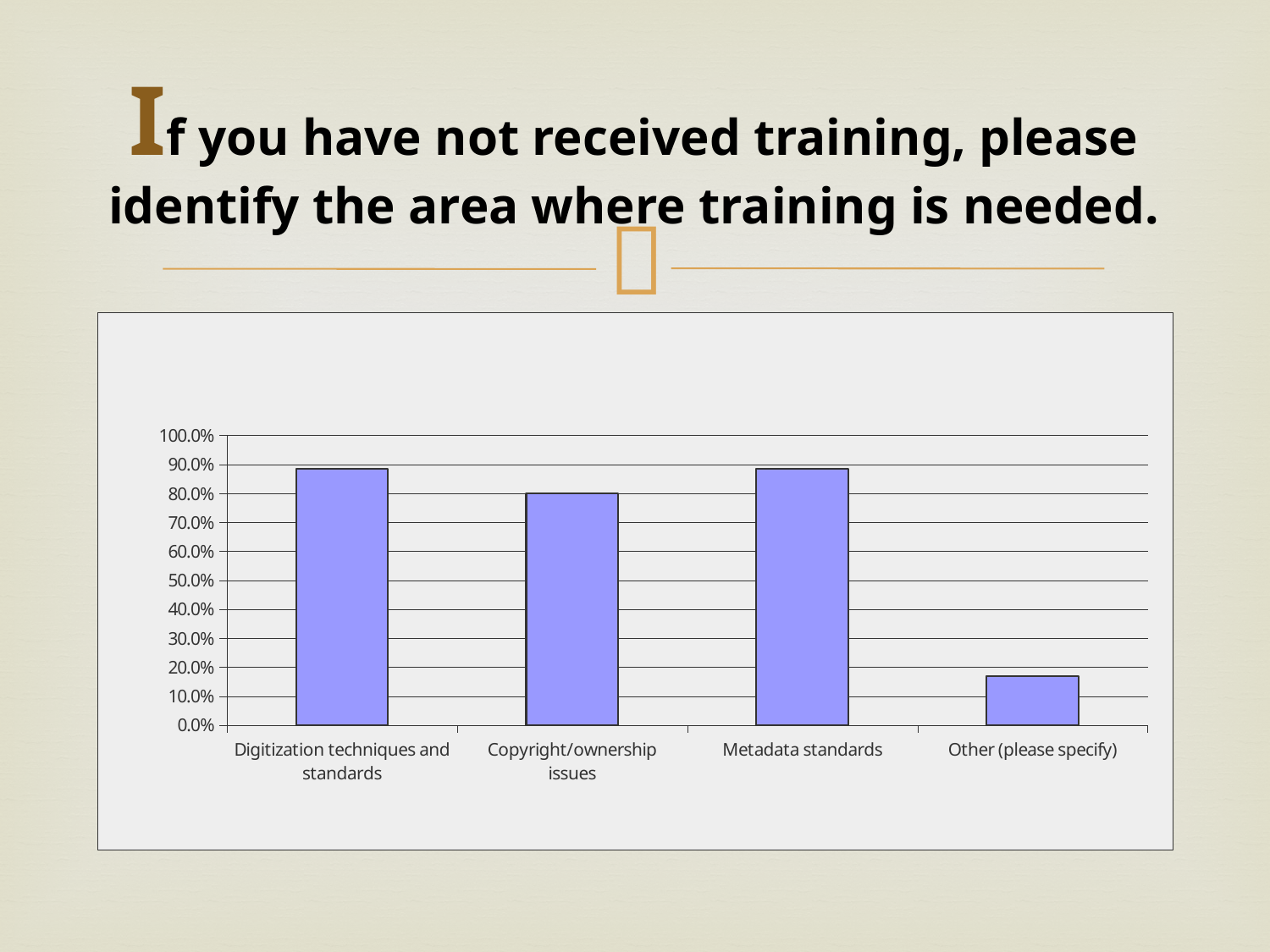
Is the value for Metadata standards greater or less than 80.0%? greater Which is larger, the value for Metadata standards or the value for Copyright/ownership issues? Metadata standards What is the highest value shown on the y axis of the chart? 100.0% Is the value for Digitization techniques and standards greater or less than 90.0%? less Which is larger, the value for Copyright/ownership issues or the value for Other (please specify)? Copyright/ownership issues Is the value for Other (please specify) greater or less than 10.0%? greater Which category has the lowest value in the chart? Other (please specify) What is the label of the first category on the x axis? Digitization techniques and standards How many categories are shown on the x axis of the chart? 4 What kind of chart is shown on the slide? bar chart